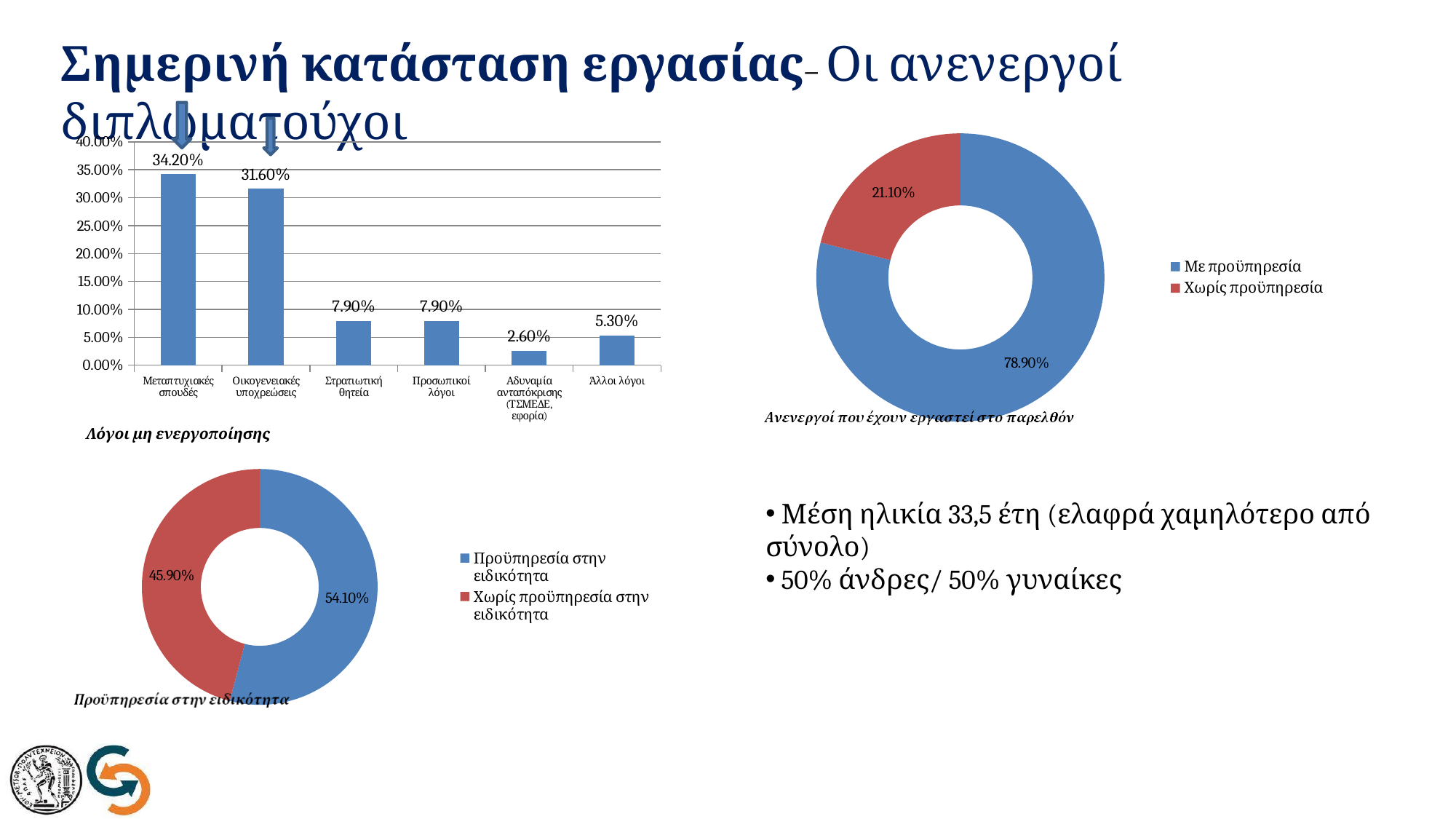
In the bar chart 'Λόγοι μη ενεργοποίησης', which category has the highest value? Μεταπτυχιακές σπουδές In the bar chart 'Λόγοι μη ενεργοποίησης', how many categories are shown? 6 In the chart 'Ανενεργοί που έχουν εργαστεί στο παρελθόν', what is the value for Χωρίς προϋπηρεσία? 21.10% What kind of chart is 'Λόγοι μη ενεργοποίησης'? Bar chart In the bar chart 'Λόγοι μη ενεργοποίησης', which category has the lowest value? Αδυναμία ανταπόκρισης (ΤΣΜΕΔΕ, εφορία) In the bar chart 'Λόγοι μη ενεργοποίησης', what is the value for Άλλοι λόγοι? 5.30% In the bar chart 'Λόγοι μη ενεργοποίησης', what is the difference between Μεταπτυχιακές σπουδές and Οικογενειακές υποχρεώσεις? 2.60% How many entries does the legend of the chart 'Προϋπηρεσία στην ειδικότητα' list? 2 In the chart 'Προϋπηρεσία στην ειδικότητα', which slice is larger: Προϋπηρεσία στην ειδικότητα or Χωρίς προϋπηρεσία στην ειδικότητα? Προϋπηρεσία στην ειδικότητα In the bar chart 'Λόγοι μη ενεργοποίησης', what is the value for Μεταπτυχιακές σπουδές? 34.20% In the chart 'Ανενεργοί που έχουν εργαστεί στο παρελθόν', what share is Με προϋπηρεσία? 78.90% In the bar chart 'Λόγοι μη ενεργοποίησης', which is larger: Άλλοι λόγοι or Αδυναμία ανταπόκρισης (ΤΣΜΕΔΕ, εφορία)? Άλλοι λόγοι